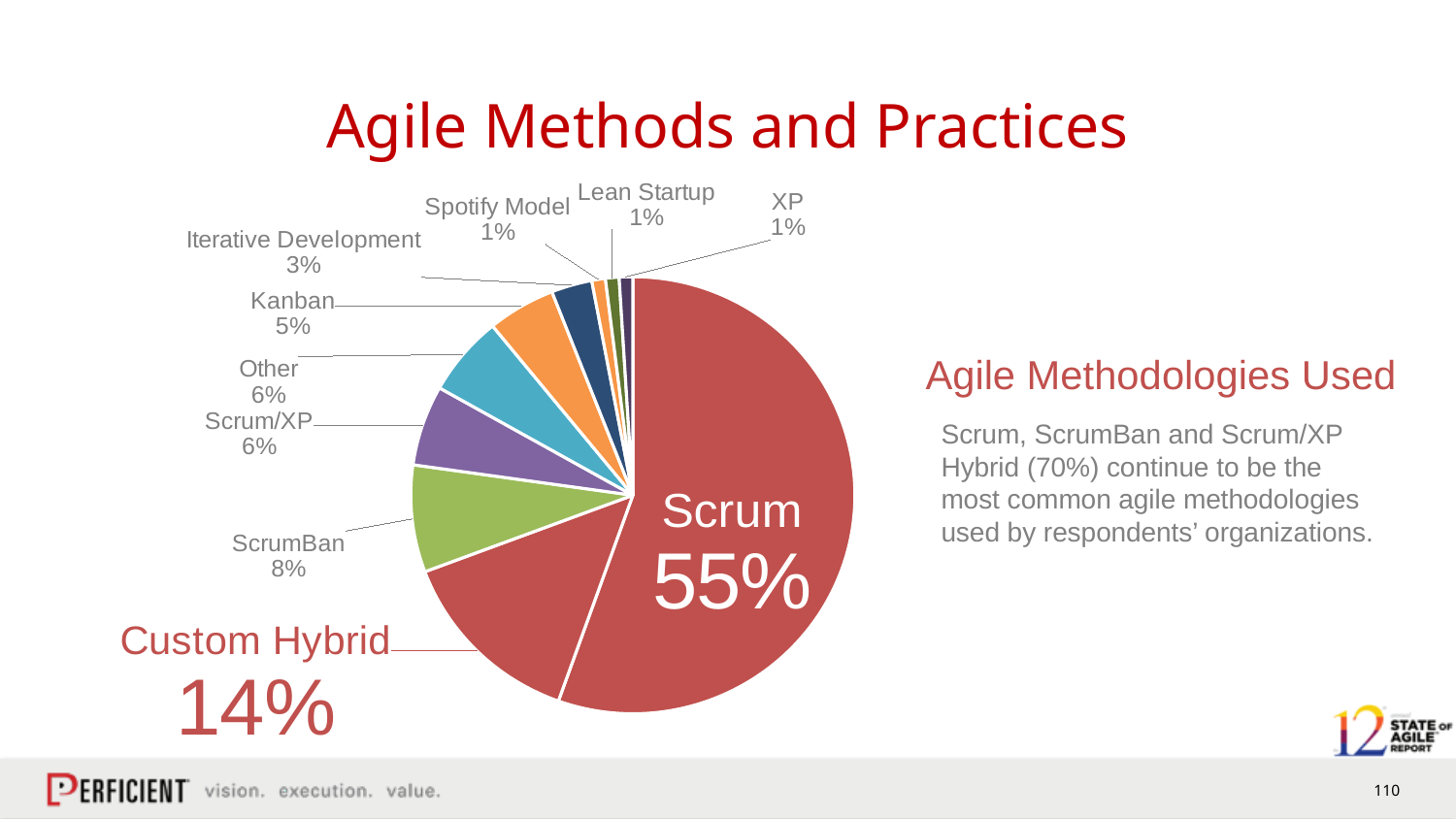
What is the difference between the ScrumBan and Scrum/XP values? 2% How many categories are shown in the pie chart? 10 What is the value for ScrumBan? 8% What is the value for Custom Hybrid? 14% What is the value for Iterative Development? 3% What share of the pie does Scrum have? 55% Which is larger, ScrumBan or Kanban? ScrumBan Which category has the largest slice of the pie? Scrum What is the difference between the Scrum and Custom Hybrid values? 41% What is the value for Kanban? 5% What is the title of the slide containing the pie chart? Agile Methods and Practices What kind of chart is shown on the slide? pie chart